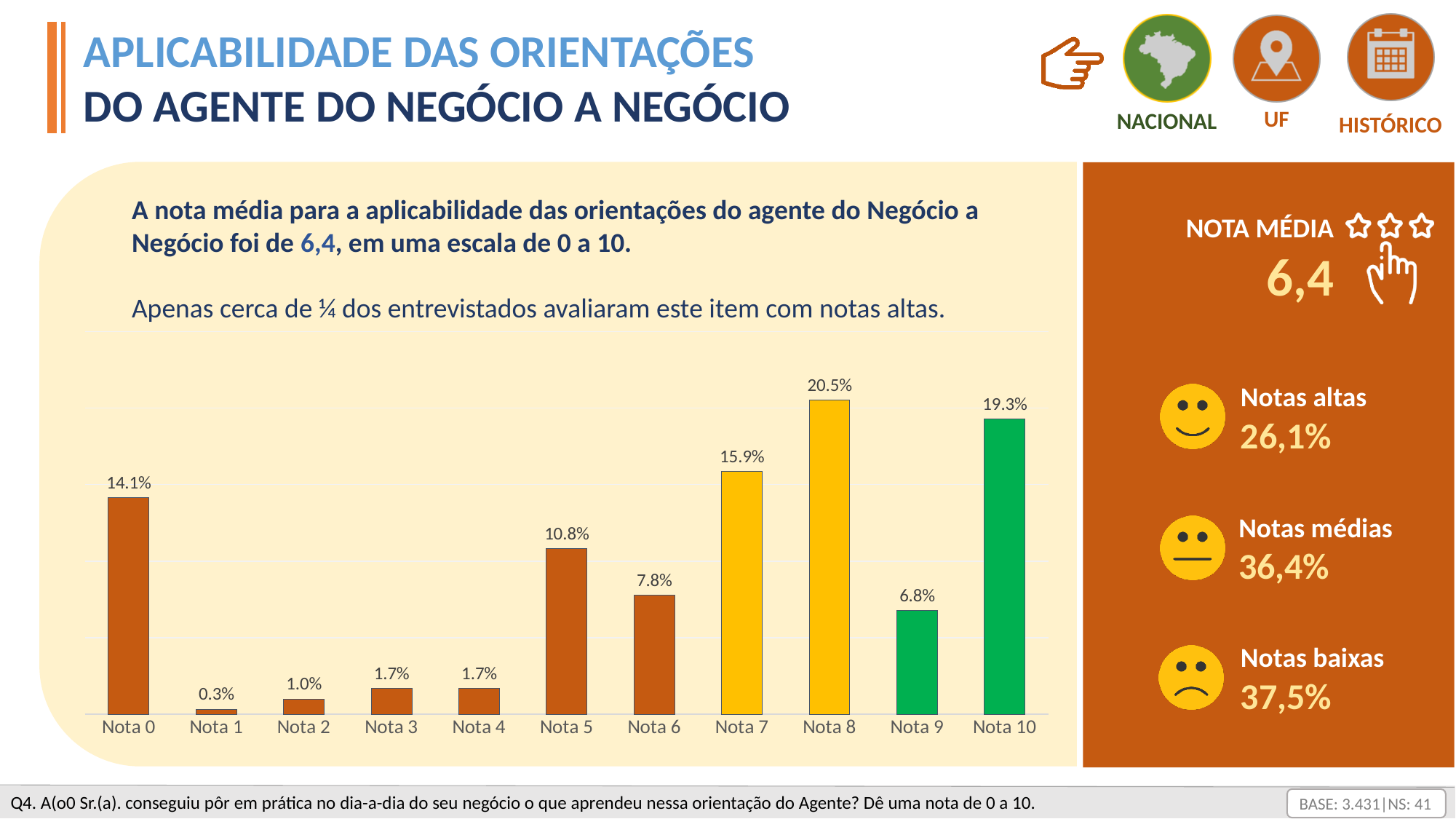
What kind of chart is shown on the slide? Bar chart How many categories are shown on the x axis? 11 Which category has the highest value? Nota 8 What is the value for Nota 8? 20.5% What is the value for Nota 0? 14.1% What colour are the bars for Nota 9 and Nota 10? Green Which category has the lowest value? Nota 1 What is the difference between the values for Nota 10 and Nota 9? 12.5% Do the values rise or fall from Nota 1 to Nota 5? Rise What is the combined value of Nota 3 and Nota 4? 3.4% Which is larger, the value for Nota 5 or the value for Nota 6? Nota 5 What is the value for Nota 9? 6.8%